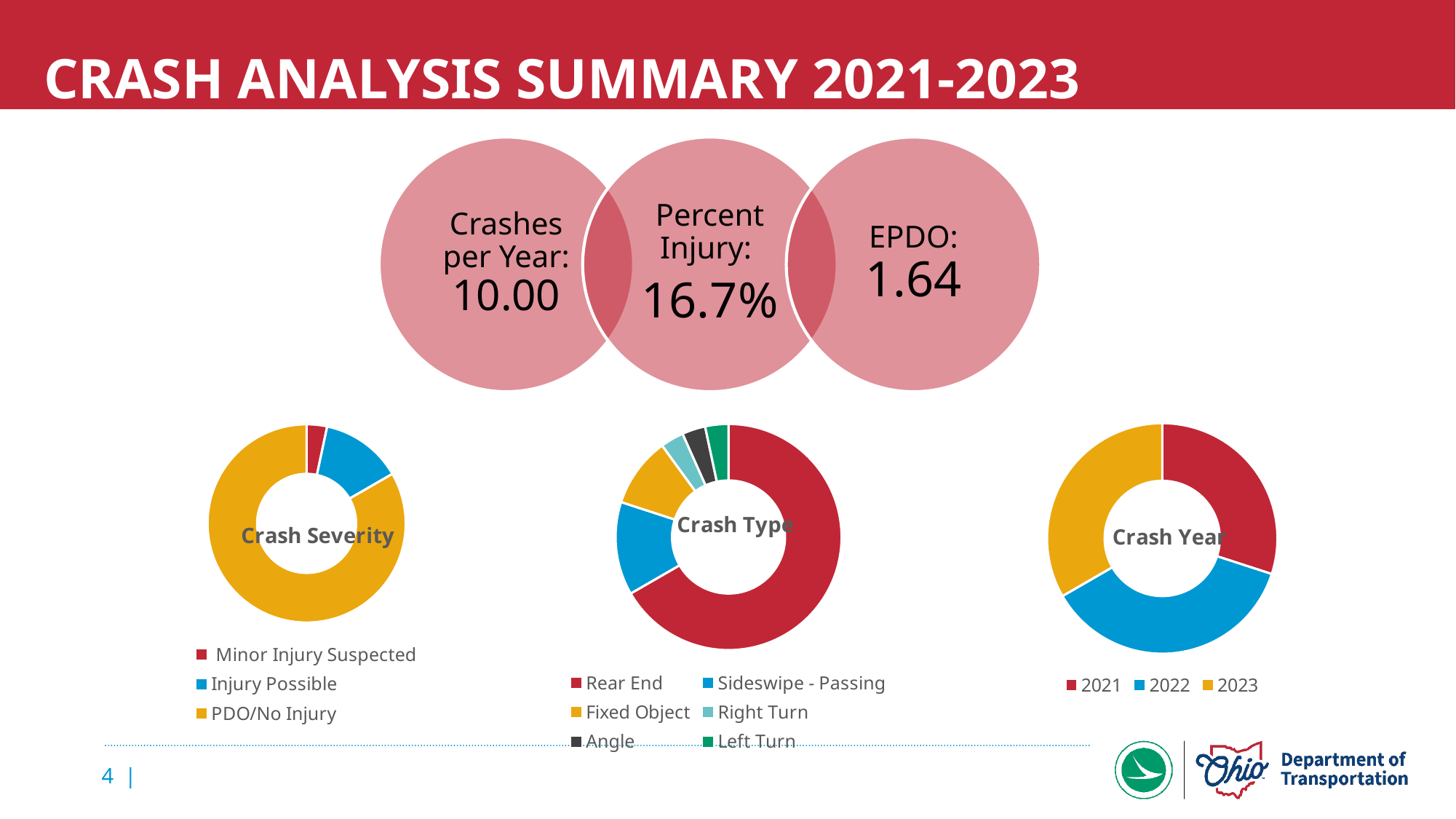
In the Crash Type chart, which is larger: Rear End or Sideswipe - Passing? Rear End How many categories does the Crash Severity chart's legend list? 3 In the Crash Severity chart, which category has the largest share? PDO/No Injury What colour represents 2022 in the Crash Year chart? blue In the Crash Type chart, which crash type has the largest share? Rear End How many categories does the Crash Type chart's legend list? 6 What colour represents Rear End in the Crash Type chart? red In the Crash Type chart, which is larger: Sideswipe - Passing or Fixed Object? Sideswipe - Passing How many categories does the Crash Year chart's legend list? 3 In the Crash Severity chart, which category has the smallest share? Minor Injury Suspected In the Crash Severity chart, which is larger: Injury Possible or Minor Injury Suspected? Injury Possible What kind of chart is the Crash Severity chart? doughnut chart